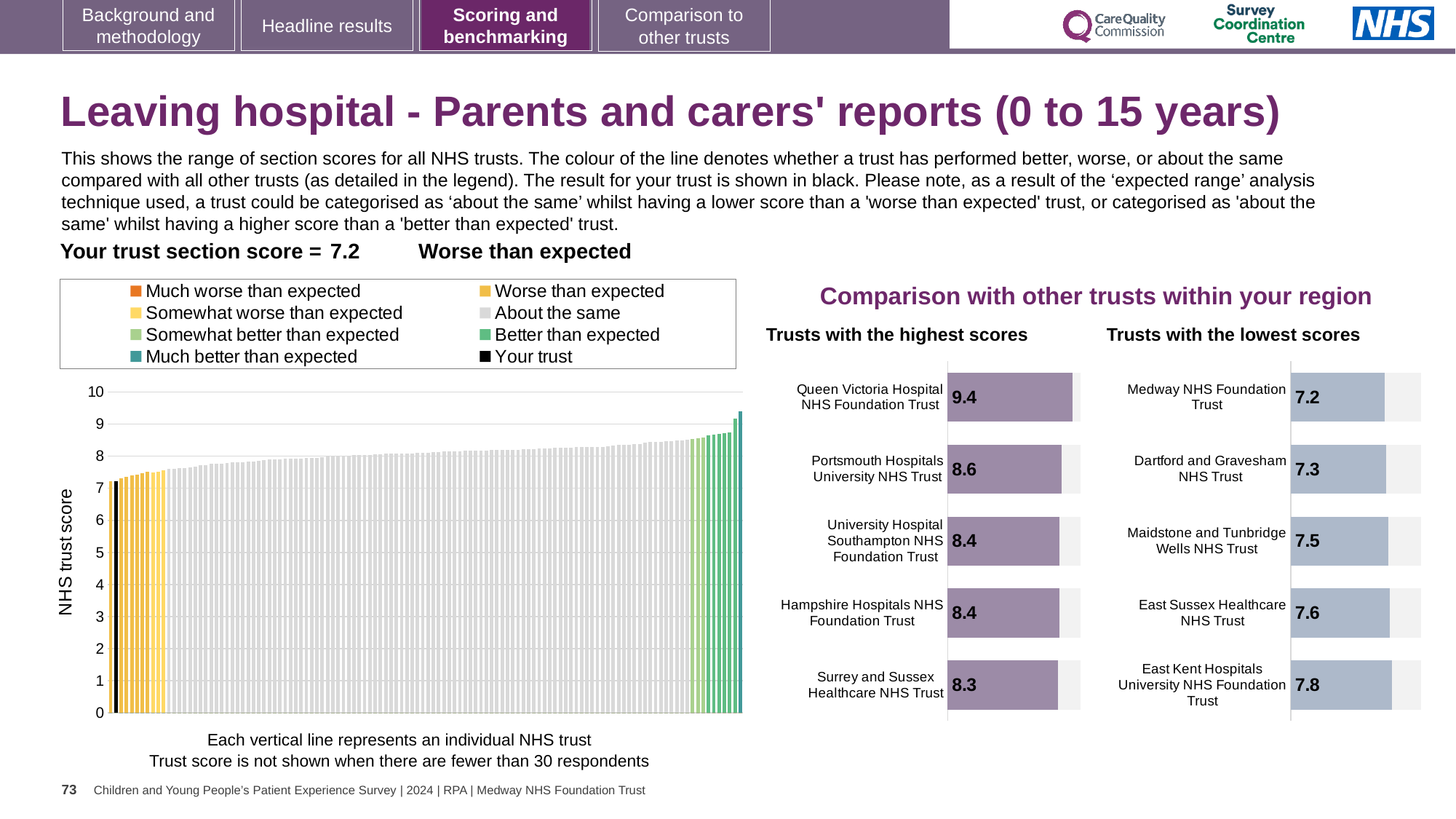
In the 'Trusts with the highest scores' chart, what is the difference between the scores of Queen Victoria Hospital NHS Foundation Trust and Surrey and Sussex Healthcare NHS Trust? 1.1 In the 'Trusts with the lowest scores' chart, which trust has the highest score? East Kent Hospitals University NHS Foundation Trust In the 'Trusts with the lowest scores' chart, what is the difference between the scores of East Kent Hospitals University NHS Foundation Trust and Medway NHS Foundation Trust? 0.6 In the main chart on the left, do the trust scores rise or fall from left to right? rise In the 'Trusts with the lowest scores' chart, what is the score for Maidstone and Tunbridge Wells NHS Trust? 7.5 In the 'Trusts with the highest scores' chart, which trust has the lowest score? Surrey and Sussex Healthcare NHS Trust What kind of chart is the main chart on the left of the slide? bar chart How many trusts are listed in the 'Trusts with the highest scores' chart? 5 In the 'Trusts with the highest scores' chart, what is the score for Queen Victoria Hospital NHS Foundation Trust? 9.4 How many entries does the legend of the main chart on the left list? 8 In the 'Trusts with the lowest scores' chart, which has the higher score: Dartford and Gravesham NHS Trust or East Sussex Healthcare NHS Trust? East Sussex Healthcare NHS Trust In the main chart on the left, is the value for the black 'Your trust' bar greater or less than 8? less